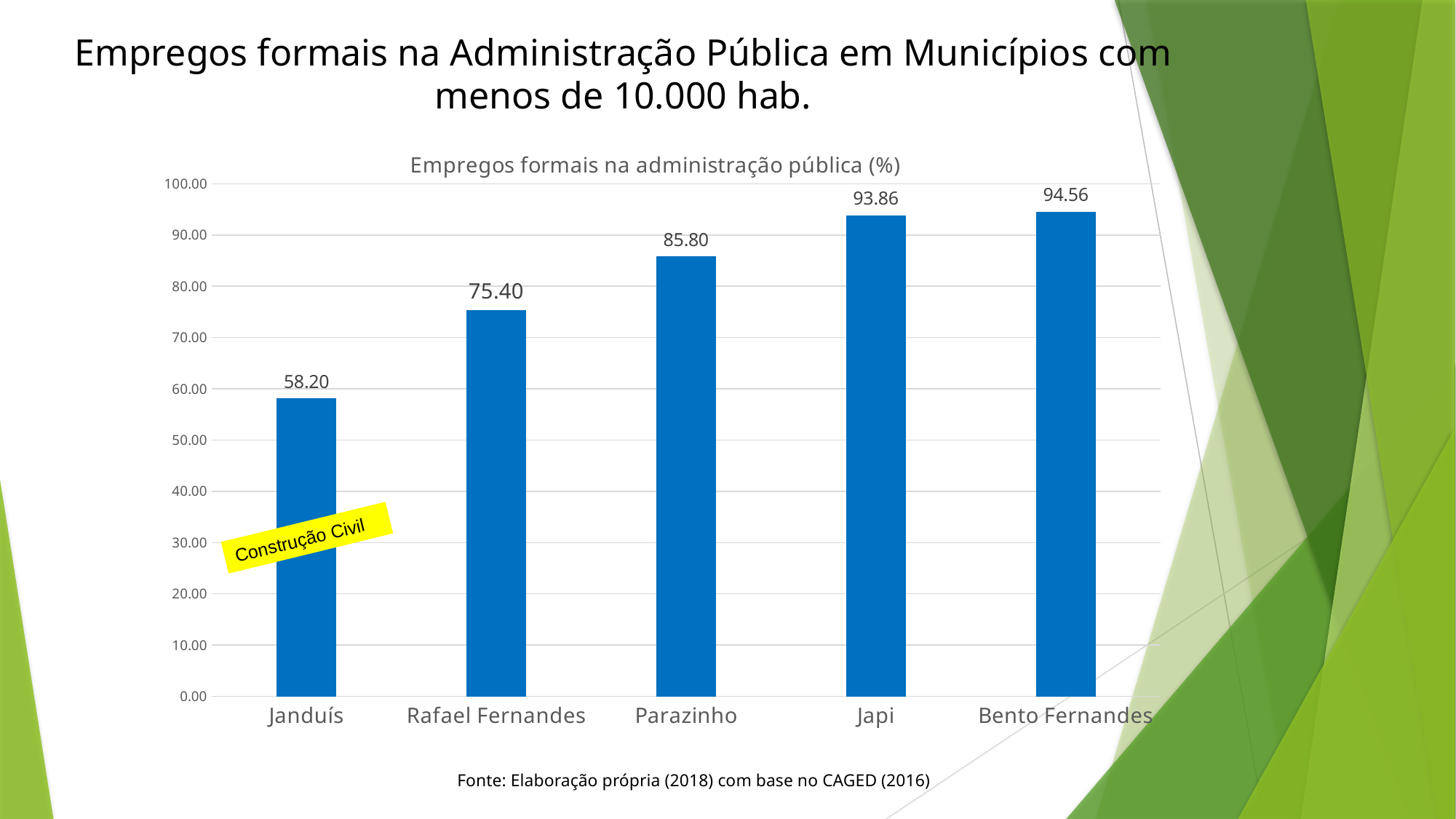
What is the difference between the values for Parazinho and Rafael Fernandes? 10.40 What is the value for Japi? 93.86 What is the value for Parazinho? 85.80 Which municipality has the lowest value? Janduís What is the value for Rafael Fernandes? 75.40 What is the difference between the values for Bento Fernandes and Janduís? 36.36 Which is larger, the value for Parazinho or the value for Rafael Fernandes? Parazinho What kind of chart is shown on the slide? Bar chart How many municipalities are shown in the chart? 5 What is the value for Bento Fernandes? 94.56 What is the value for Janduís? 58.20 Do the values rise or fall from left to right along the x axis? Rise